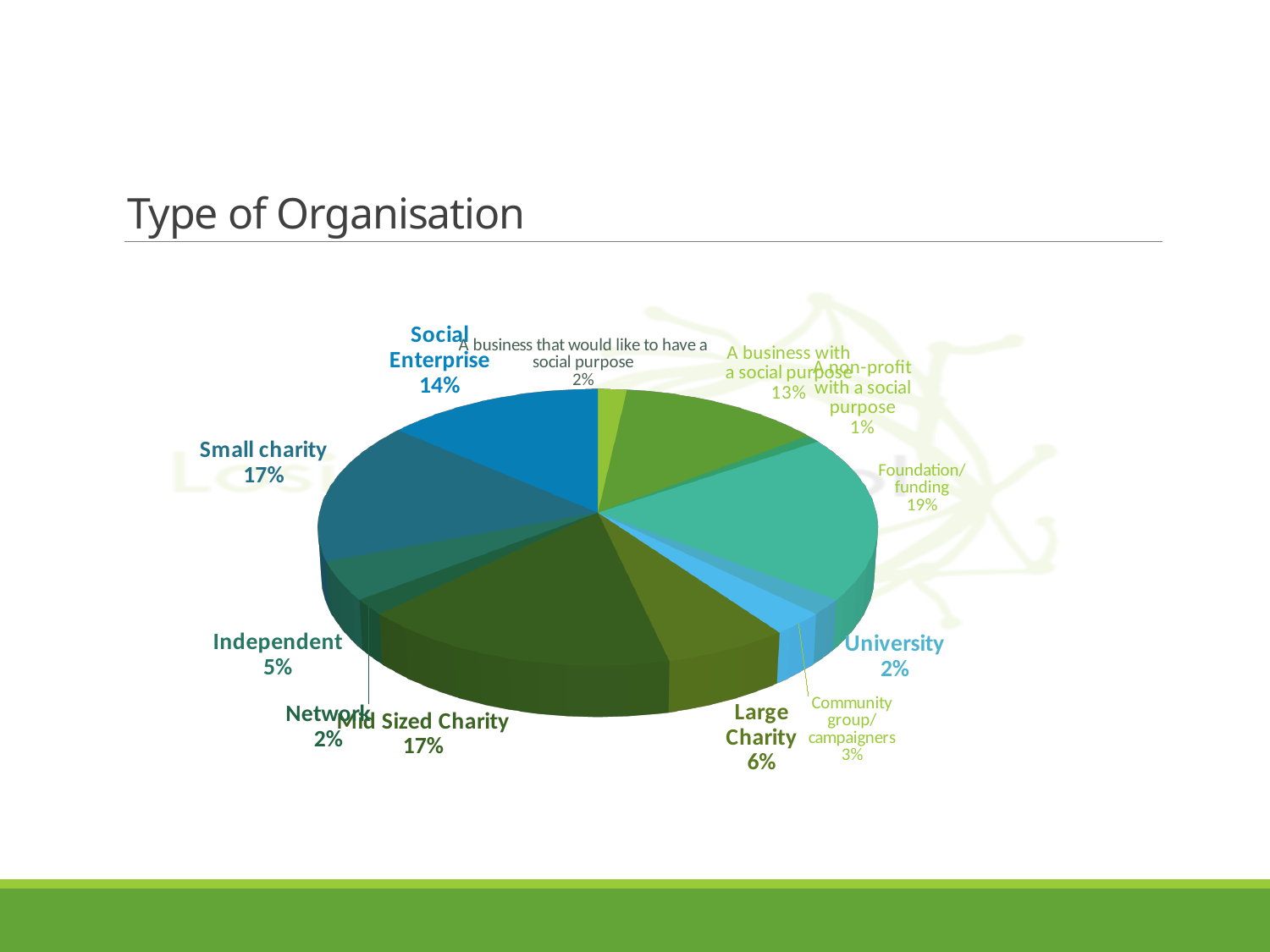
How many categories are shown in the pie chart? 12 What kind of chart is shown on the slide? Pie chart Which category has the smallest share of the pie? A non-profit with a social purpose What share of the pie is Foundation/funding? 19% What is the difference between the shares for Small charity and Independent? 12% What is the title of the chart? Type of Organisation Which is larger, the share for A business with a social purpose or the share for Large Charity? A business with a social purpose What percentage is shown for Large Charity? 6% What is the combined share of Mid Sized Charity and Small charity? 34% Which category has the largest share of the pie? Foundation/funding What percentage is shown for Social Enterprise? 14% What percentage is shown for Community group/campaigners? 3%